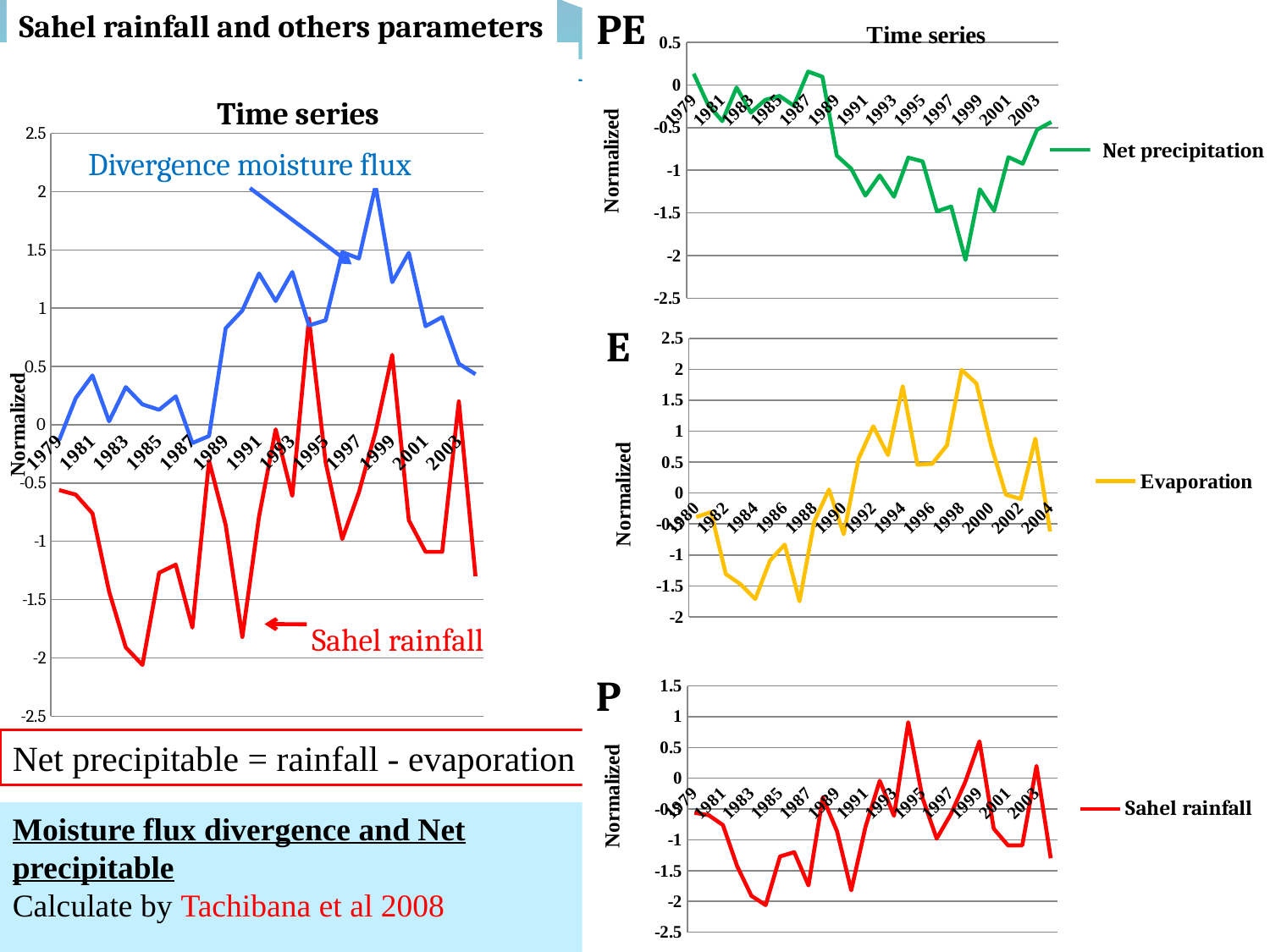
In the 'Evaporation' chart (E), is the value for 1984 greater or less than -1? less In the 'Net precipitation' chart (PE), do the values overall rise or fall from 1979 to 2004? Fall In the 'Net precipitation' chart (PE) on the right, how many series does the legend list? 1 In the left 'Time series' chart, what colour is the Sahel rainfall line? Red In the 'Net precipitation' chart (PE), is the value for 1999 greater or less than -1.5? greater In the left 'Time series' chart, is the Divergence moisture flux value for 1999 greater or less than 1.5? less How many charts are shown on the slide? 4 In the 'Evaporation' chart (E), which is larger: the value for 1998 or the value for 1984? 1998 In the 'Net precipitation' chart (PE), which year has the lowest value? 1998 What kind of chart is the large 'Time series' chart on the left of the slide? Line chart